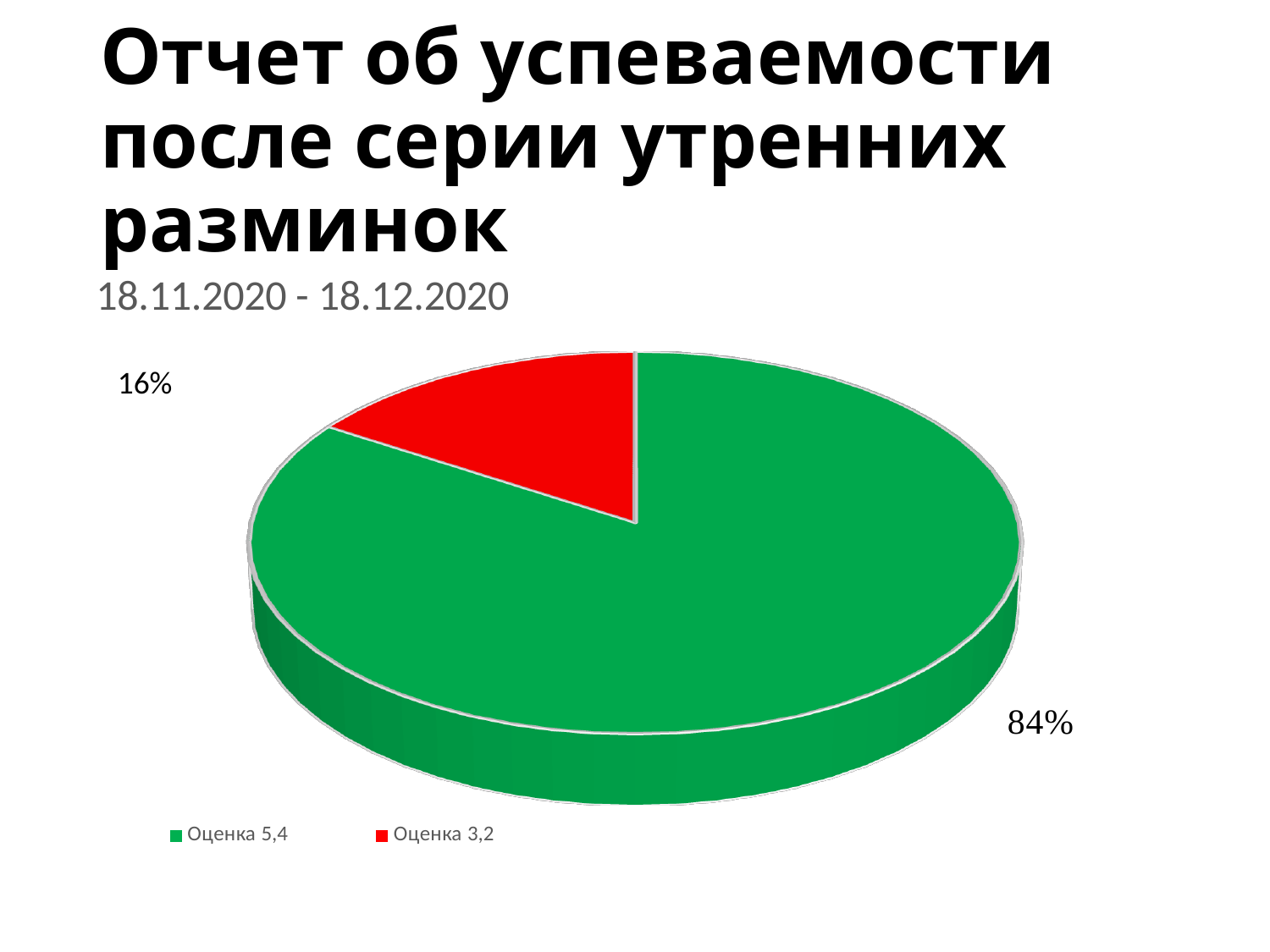
What is the difference in percentage points between the "Оценка 5,4" slice and the "Оценка 3,2" slice? 68 What share of the pie does "Оценка 5,4" have? 84% What colour is the "Оценка 3,2" slice? red Which slice is larger, "Оценка 5,4" or "Оценка 3,2"? Оценка 5,4 How many slices does the pie chart have? 2 What share of the pie does "Оценка 3,2" have? 16% Which category has the largest slice of the pie? Оценка 5,4 How many entries does the legend list? 2 What kind of chart is shown on the slide? pie chart Which category has the smallest slice of the pie? Оценка 3,2 What date range is shown under the slide title? 18.11.2020 - 18.12.2020